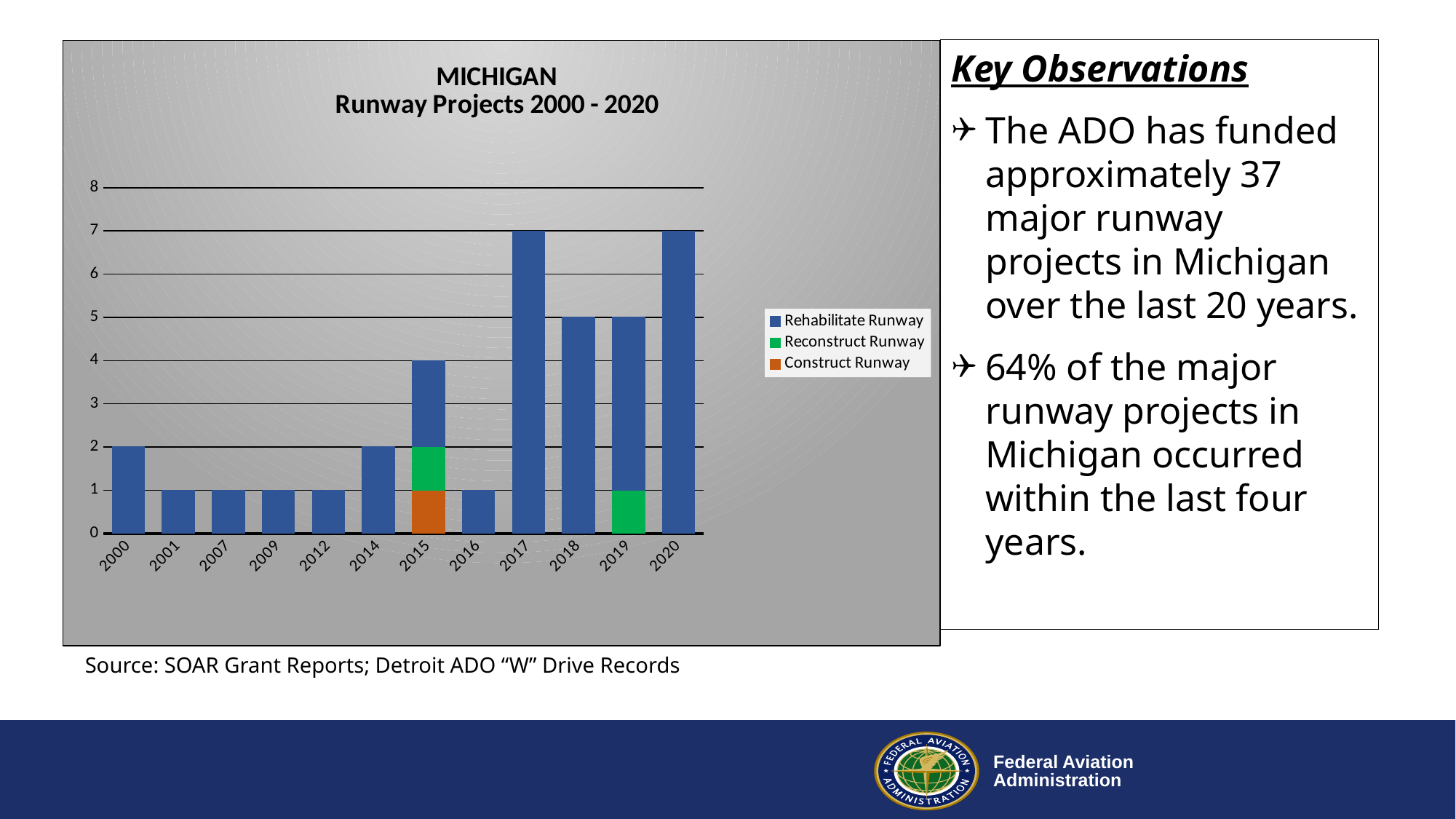
How many years are shown on the x axis of the chart? 12 What is the difference between the number of projects in 2017 and in 2018? 2 What kind of chart is shown on the slide? bar chart How many runway projects are shown for 2018? 5 How many runway projects are shown for 2017? 7 How many Construct Runway projects are shown for 2015? 1 What colour represents Reconstruct Runway in the legend? green How many series does the legend list? 3 How many Rehabilitate Runway projects are shown for 2000? 2 Which year has more runway projects, 2014 or 2016? 2014 Is the value for 2020 greater or less than 5? greater What is the total number of runway projects in the stacked bar for 2015? 4